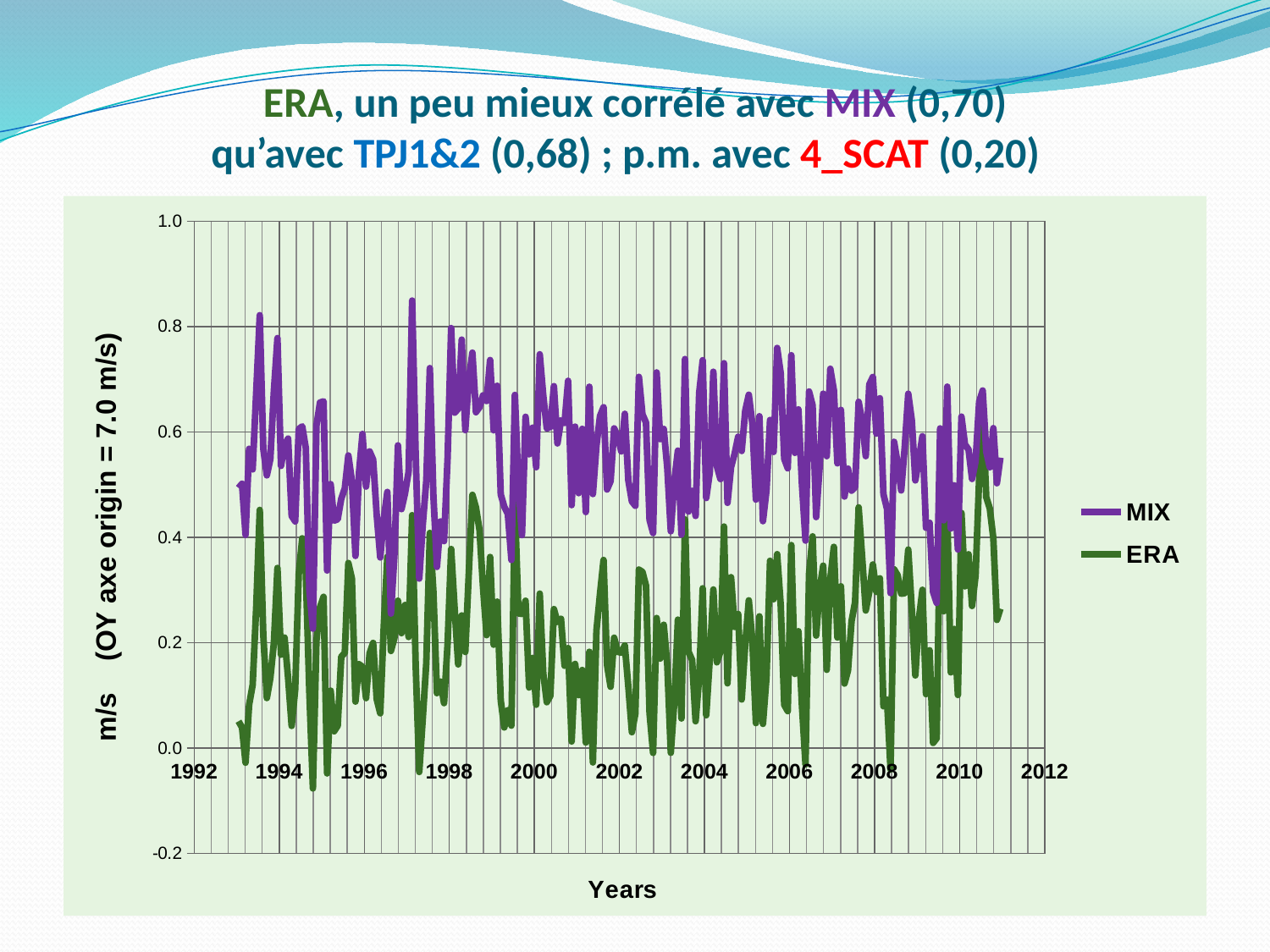
What are the names of the two series in the legend? MIX and ERA What is the title of the x axis? Years How many series does the legend list? 2 Is the highest value reached by the MIX series greater or less than 0.8? greater How many year labels are shown on the x axis? 11 Is the lowest value reached by the ERA series greater or less than 0.0? less Which series reaches the lowest value on the chart, MIX or ERA? ERA Which series, MIX or ERA, has generally higher values across the chart? MIX Is the first plotted value of the ERA series (around 1993) greater or less than 0.2? less What kind of chart is shown on the slide? line chart